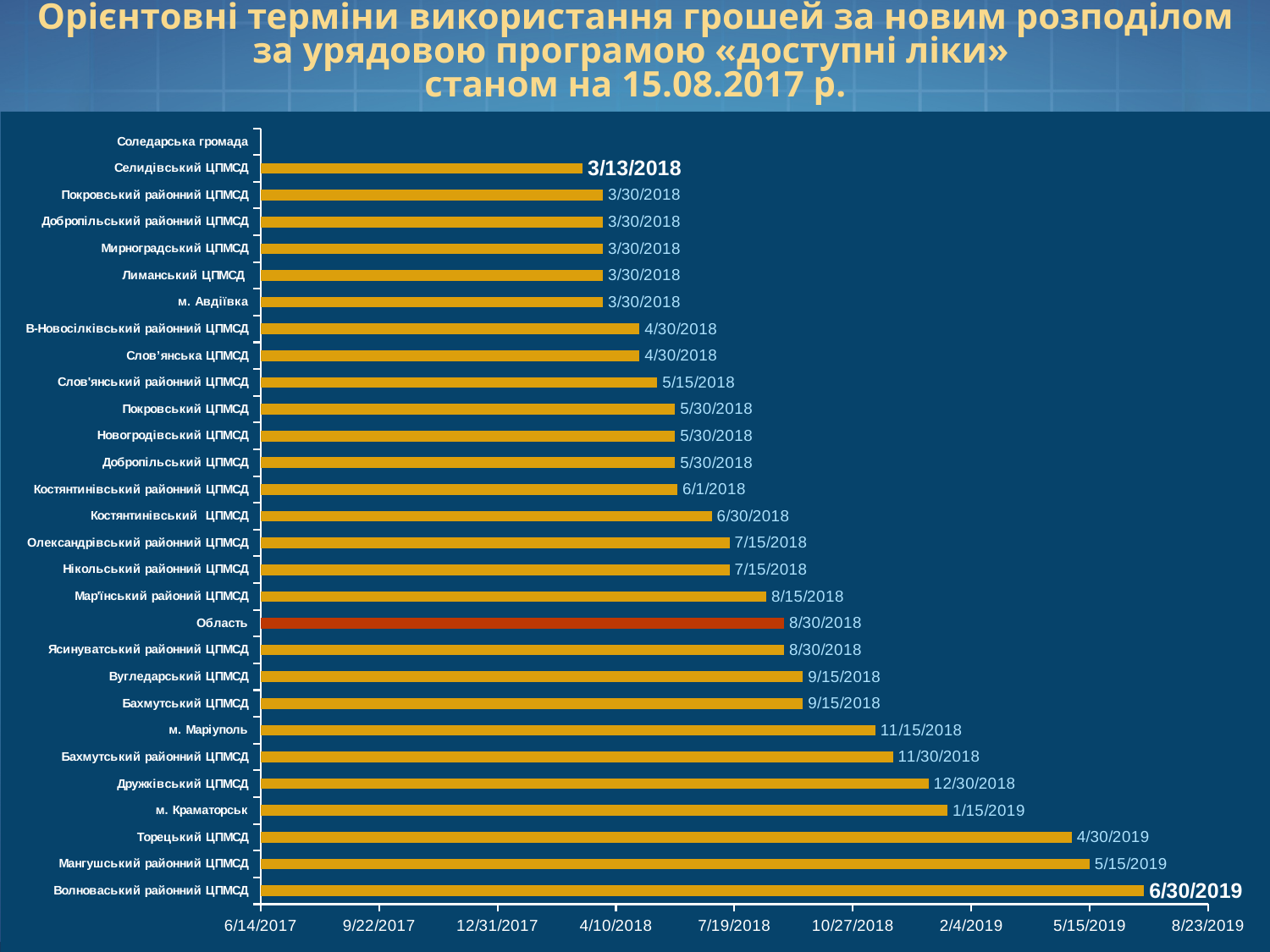
What date is shown for Волноваський районний ЦПМСД? 6/30/2019 What date is shown for Область? 8/30/2018 What date is shown for м. Маріуполь? 11/15/2018 Which category's bar is drawn in a different (red) colour from the others? Область Which has a later date, Торецький ЦПМСД or Дружківський ЦПМСД? Торецький ЦПМСД What kind of chart is shown on the slide? bar chart Which category has the latest date (longest bar)? Волноваський районний ЦПМСД Among the categories with a bar, which has the earliest date (shortest bar)? Селидівський ЦПМСД What date is shown for Торецький ЦПМСД? 4/30/2019 Which has a later date, Мангушський районний ЦПМСД or м. Краматорськ? Мангушський районний ЦПМСД What date is shown for Селидівський ЦПМСД? 3/13/2018 What date is shown for м. Краматорськ? 1/15/2019